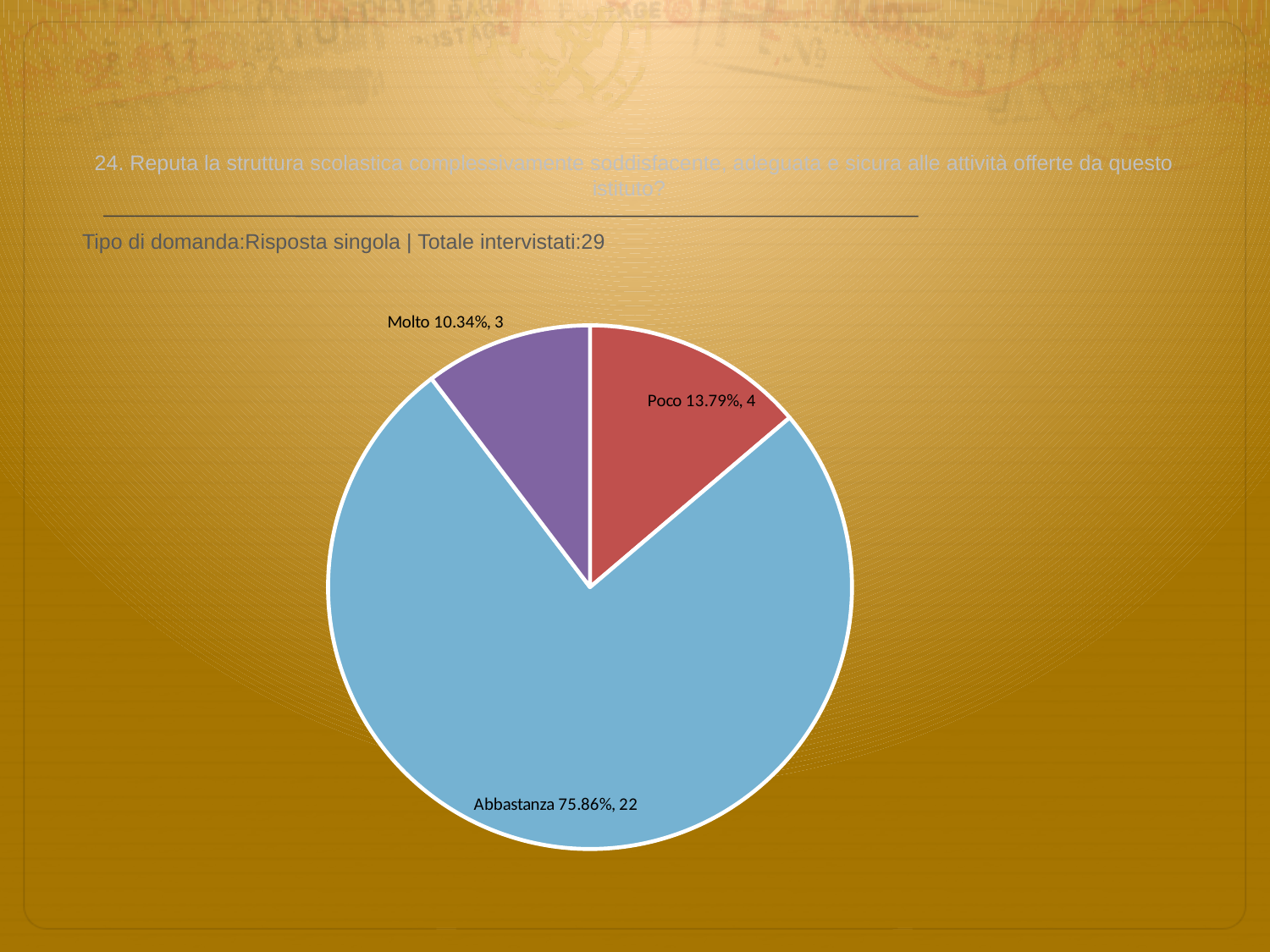
What is the total number of respondents across all slices? 29 What kind of chart is shown on the slide? pie chart What percentage share does the Abbastanza slice have? 75.86% Which has more respondents, Poco or Molto? Poco What colour is the Abbastanza slice? light blue What percentage share does the Molto slice have? 10.34% Which category has the largest slice? Abbastanza How many respondents answered Molto? 3 Which category has the smallest slice? Molto What is the difference in respondent count between Abbastanza and Poco? 18 How many respondents answered Poco? 4 How many slices does the pie chart have? 3